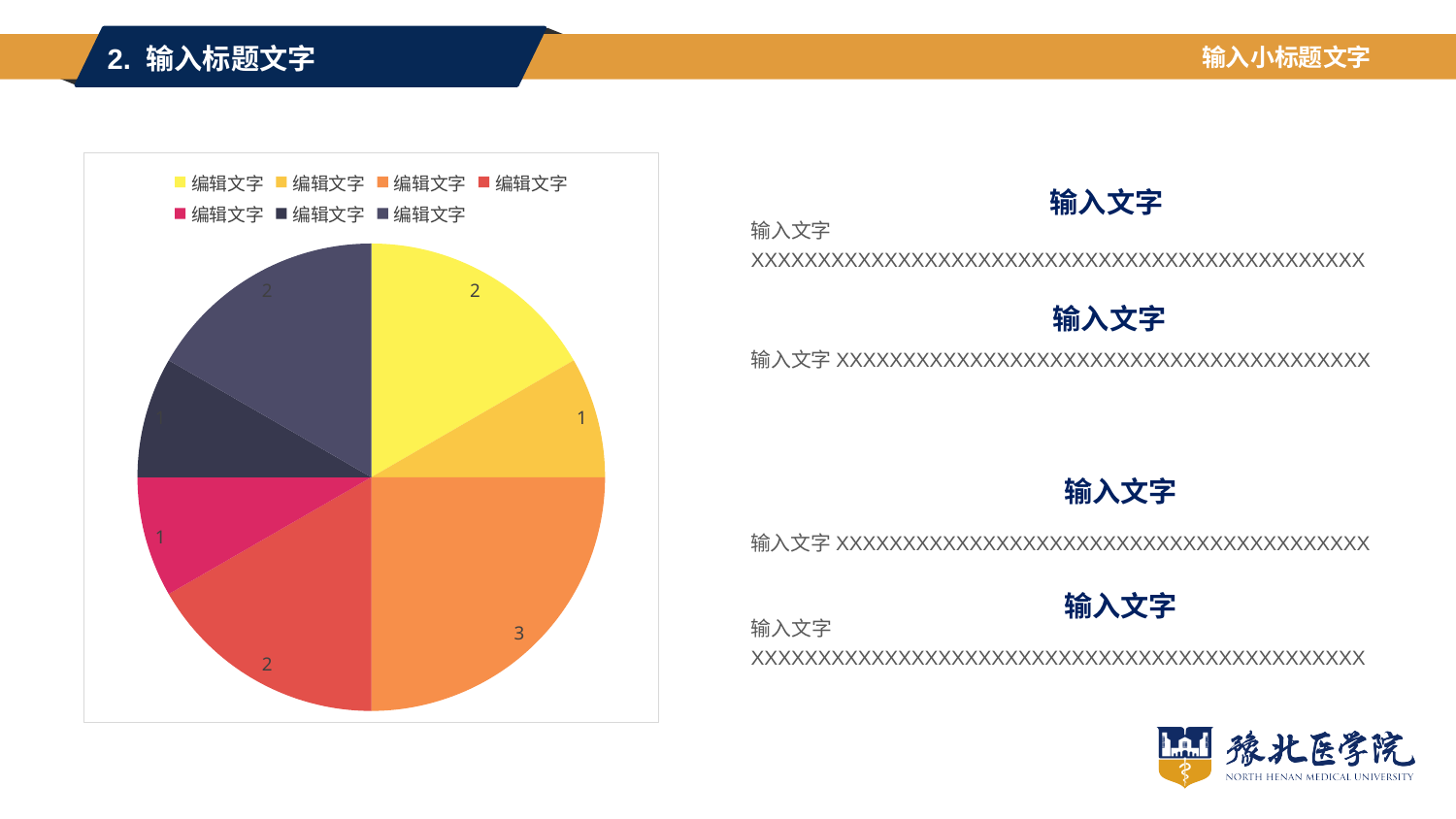
What share of the pie does the slice labelled 3 represent? 25% Which slice is larger, the orange slice or the bright yellow slice? the orange slice What is the value labelled on the orange slice of the pie chart? 3 How many slices of the pie chart are labelled with the value 2? 3 What is the largest value labelled on any slice of the pie chart? 3 What is the total of all the slice values labelled on the pie chart? 12 How many slices does the pie chart have? 7 What kind of chart is shown on the slide? pie chart What text is used for every entry in the pie chart's legend? 编辑文字 What is the value labelled on the bright yellow slice of the pie chart? 2 What is the smallest value labelled on any slice of the pie chart? 1 How many entries does the legend of the pie chart list? 7